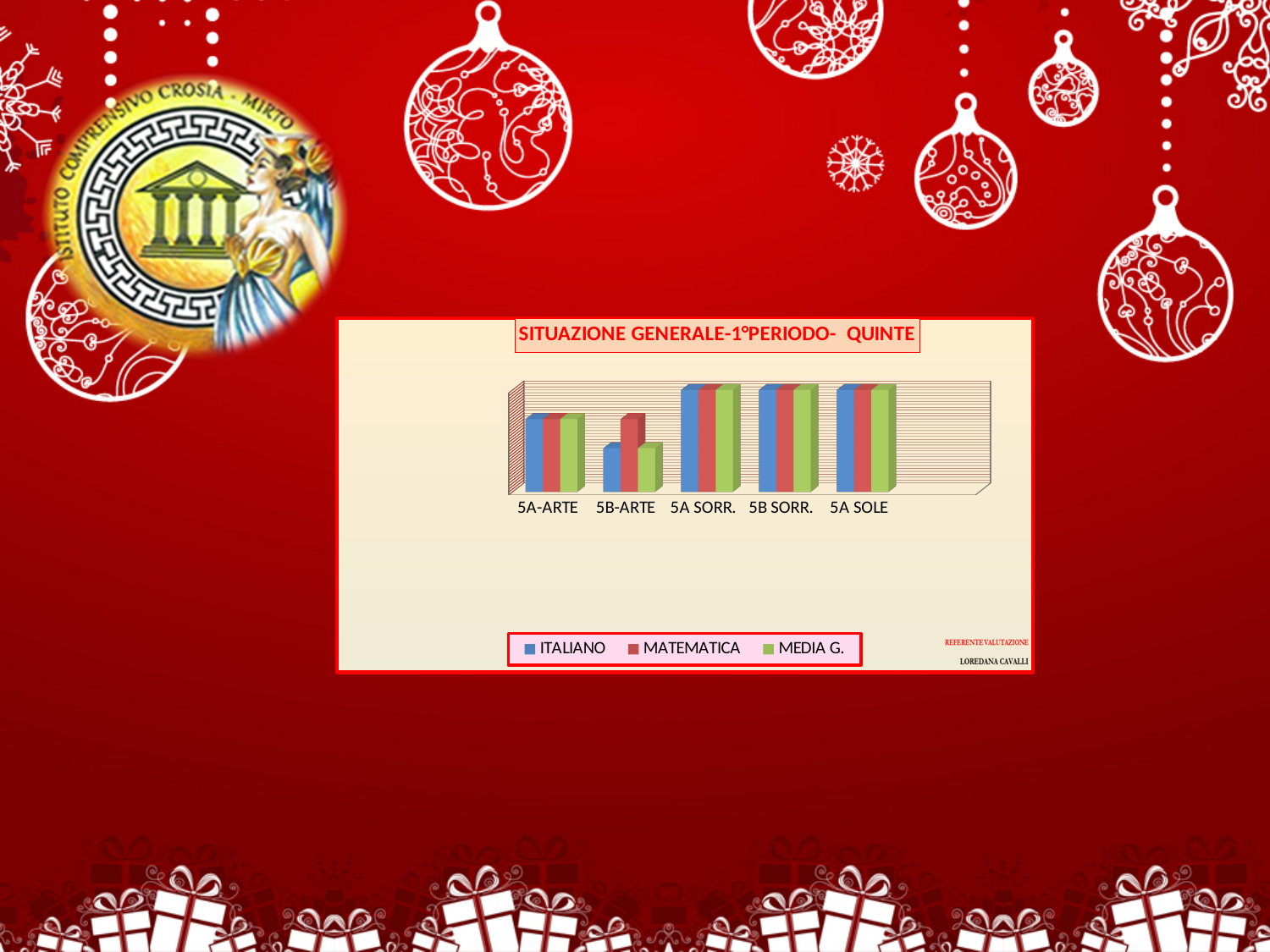
What kind of chart is shown on the slide? bar chart Which category has the lowest ITALIANO value? 5B-ARTE Is the MEDIA G. value larger for 5A SORR. or for 5B-ARTE? 5A SORR. Which category has the lowest MEDIA G. value? 5B-ARTE How many series does the chart's legend list? 3 Is the ITALIANO value larger for 5A-ARTE or for 5B-ARTE? 5A-ARTE How many categories are shown on the x axis of the chart? 5 What is the title of the chart? SITUAZIONE GENERALE-1°PERIODO- QUINTE Is the ITALIANO value larger for 5A SOLE or for 5A-ARTE? 5A SOLE Which series are listed in the chart's legend? ITALIANO, MATEMATICA, MEDIA G.